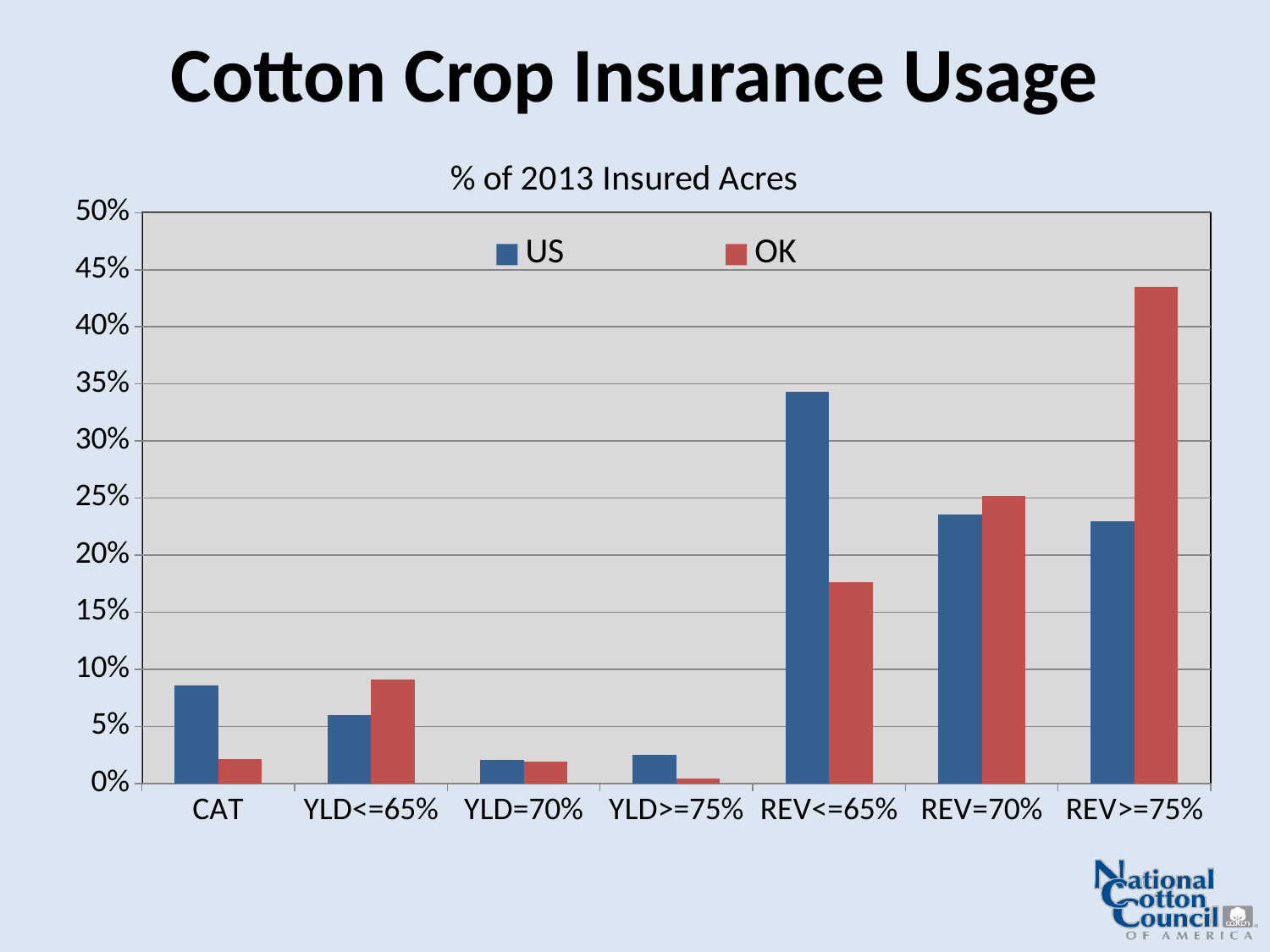
What is the subtitle shown above the chart? % of 2013 Insured Acres How many series does the legend list? 2 What kind of chart is shown on the slide? bar chart Is the OK value for REV>=75% greater or less than 40%? greater For the CAT category, which series has the larger value, US or OK? US For the REV>=75% category, which series has the larger value, US or OK? OK Which category has the highest value for the US series? REV<=65% How many categories are shown on the x axis? 7 For the YLD<=65% category, which series has the larger value, US or OK? OK Is the US value for REV<=65% greater or less than 30%? greater Which category has the highest value for the OK series? REV>=75% Which category has the lowest value for the OK series? YLD>=75%